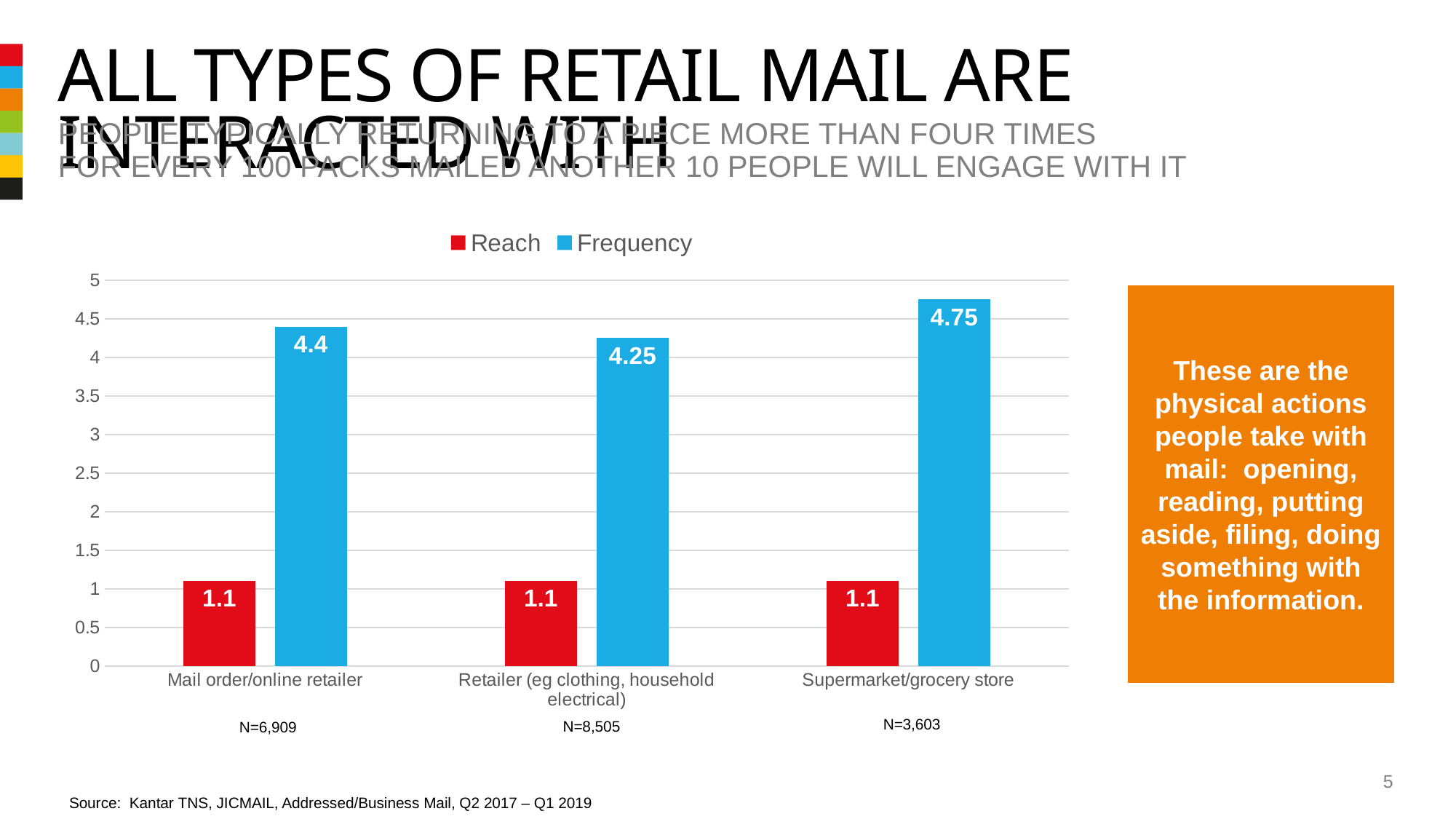
What is the Reach value for Retailer (eg clothing, household electrical)? 1.1 Which category has the highest Frequency value? Supermarket/grocery store What kind of chart is shown on the slide? bar chart Is the Frequency value for Supermarket/grocery store greater or less than 4.5? greater What is the Frequency value for Mail order/online retailer? 4.4 What is the Frequency value for Supermarket/grocery store? 4.75 Which is larger, the Frequency for Mail order/online retailer or the Frequency for Retailer (eg clothing, household electrical)? Mail order/online retailer How many categories are shown on the x axis? 3 What is the difference between the Frequency values for Supermarket/grocery store and Retailer (eg clothing, household electrical)? 0.5 How many series does the legend list? 2 What colour represents the Frequency series in the legend? blue